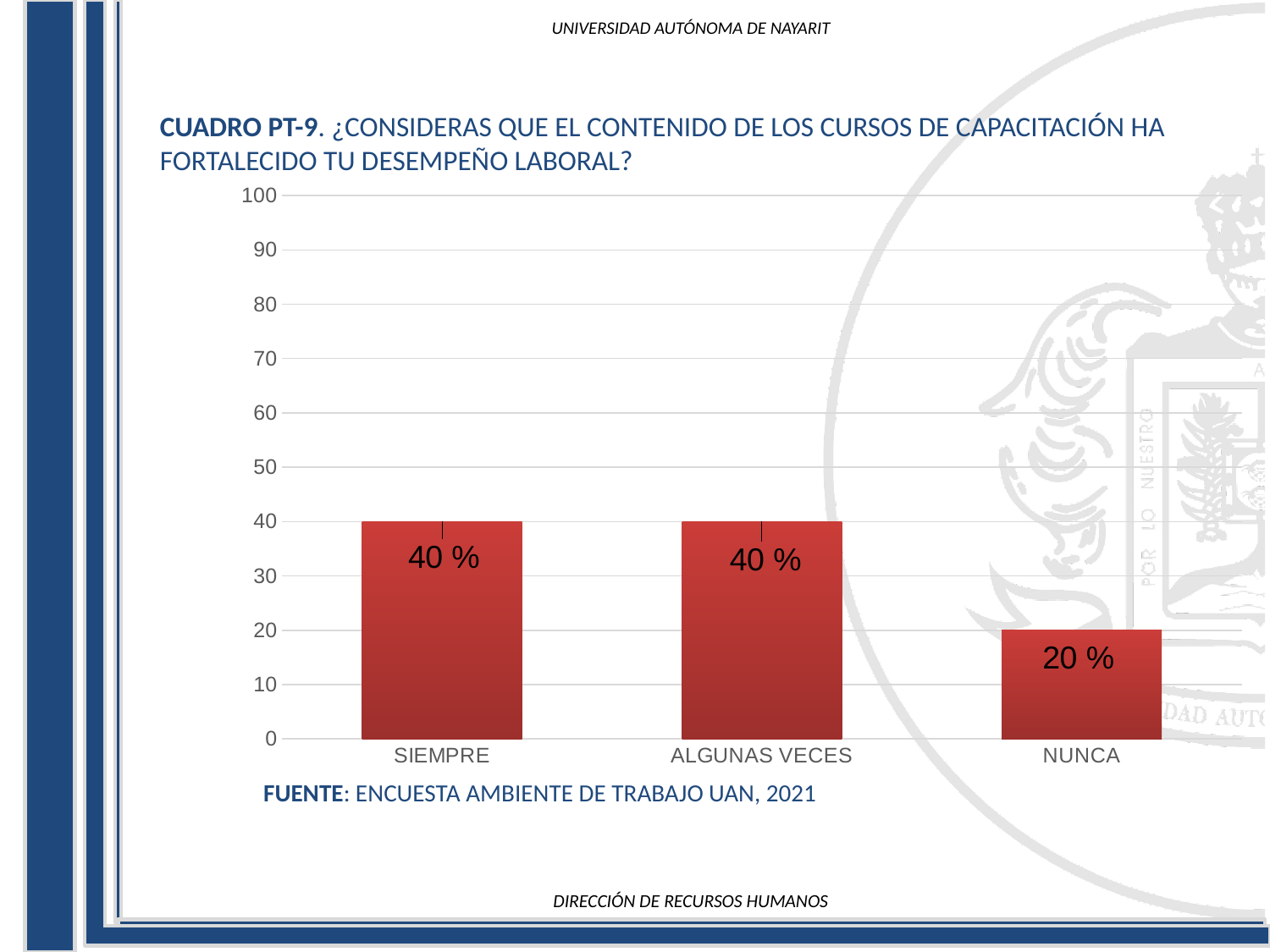
Is the value for NUNCA greater or less than 30? less What kind of chart is shown on the slide? bar chart What is the value for NUNCA? 20 % What source is cited below the chart? ENCUESTA AMBIENTE DE TRABAJO UAN, 2021 Which is larger, the value for ALGUNAS VECES or the value for NUNCA? ALGUNAS VECES Which category has the lowest value? NUNCA What is the value for SIEMPRE? 40 % What is the value for ALGUNAS VECES? 40 % What is the difference between the values for SIEMPRE and NUNCA? 20 % What is the maximum value shown on the y axis? 100 How many categories are shown on the x axis? 3 Is the value for SIEMPRE greater or less than 50? less